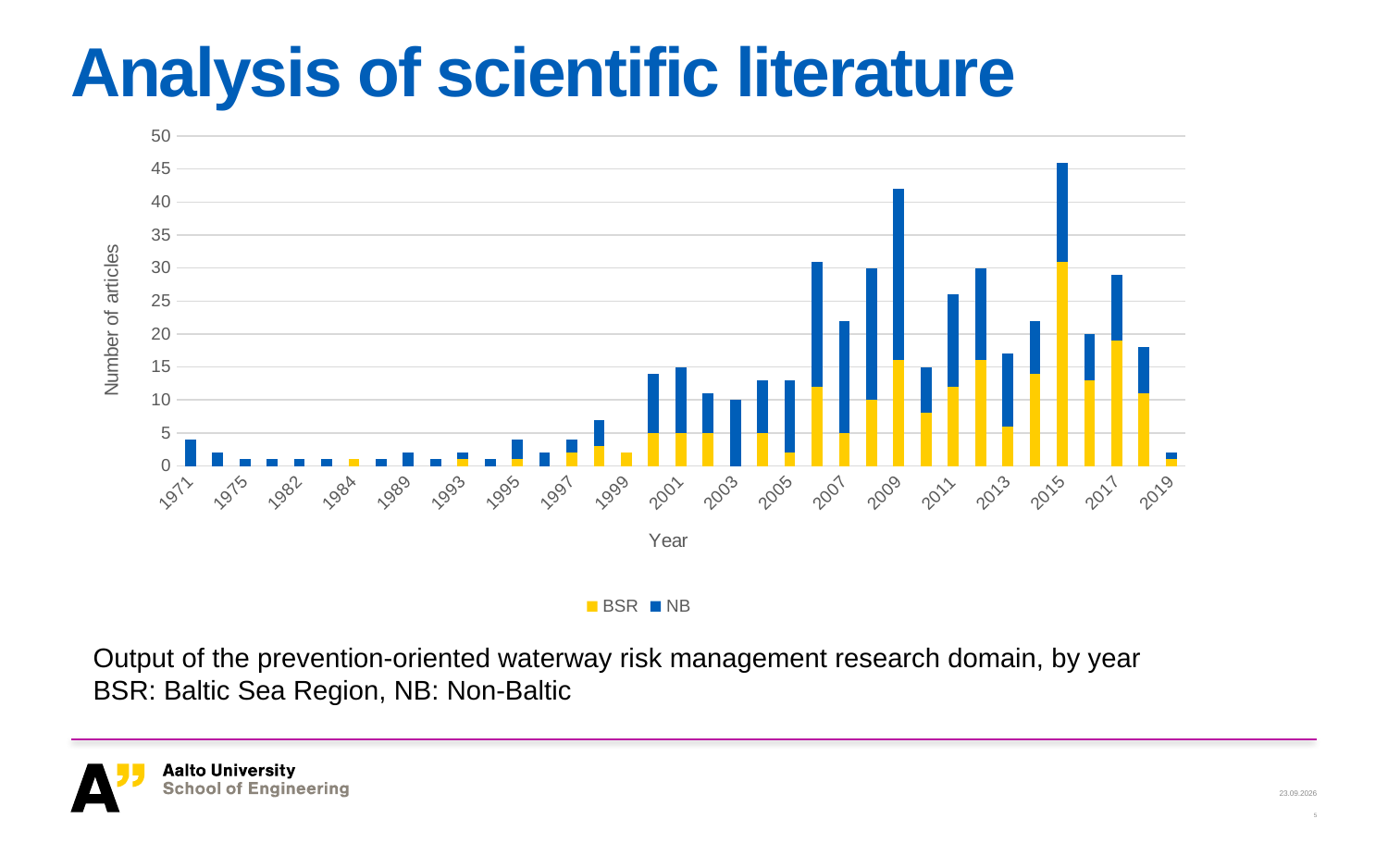
Which colour represents the BSR series in the legend? Yellow How many series does the legend list? 2 Which year has the larger total number of articles, 2009 or 2007? 2009 Which year has the larger total number of articles, 2015 or 2009? 2015 Is the total number of articles for 2019 greater or less than 5? less Is the total number of articles for 2015 greater or less than 40? greater What kind of chart is shown on the slide? Stacked bar chart Is the total number of articles for 2007 greater or less than 20? greater Which year has the tallest bar (highest total number of articles)? 2015 Overall, do the number of articles rise or fall from 1971 to 2015? rise